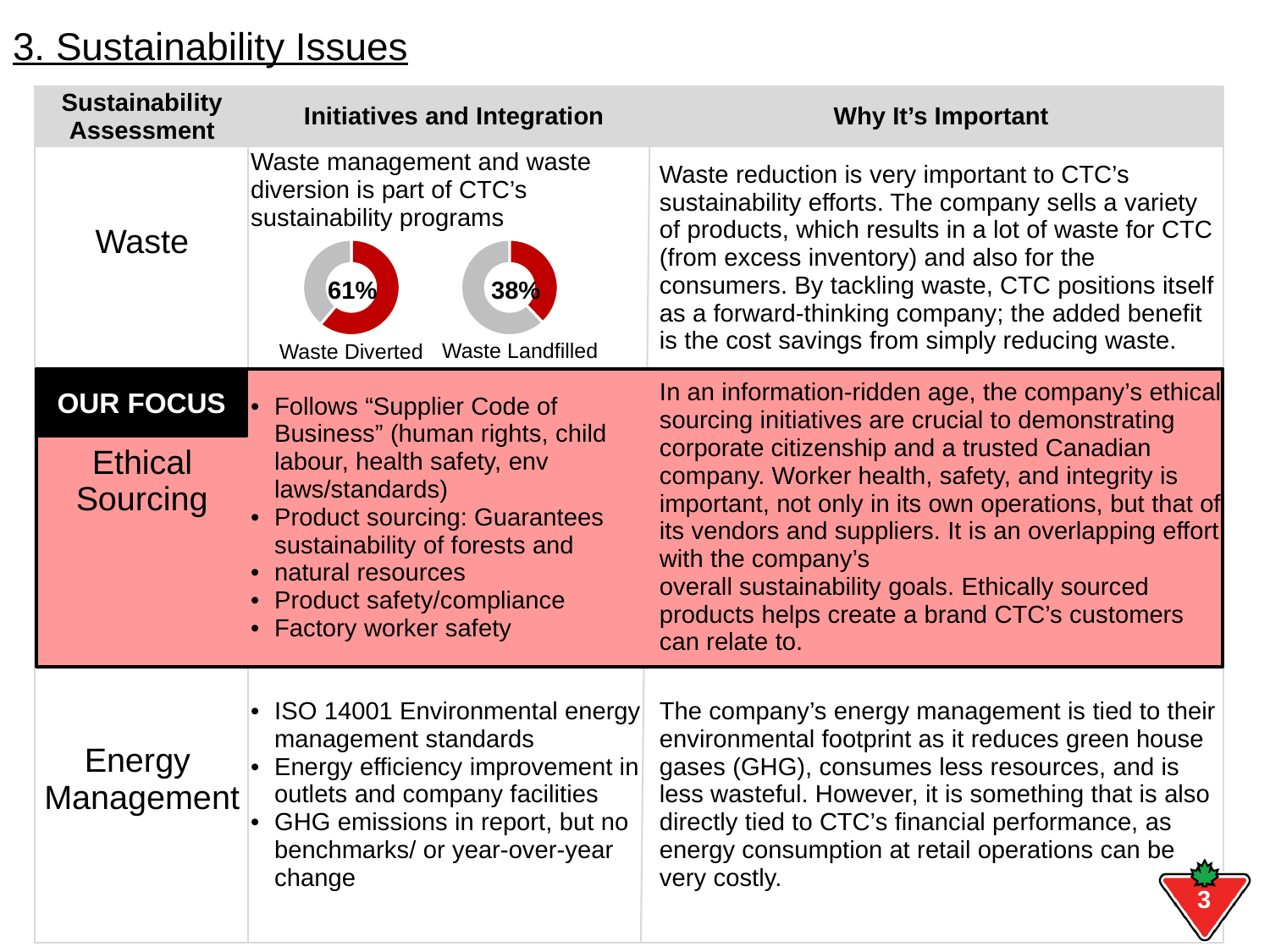
How many donut charts are shown in the Waste row of the table? 2 Is the Waste Diverted value greater or less than 50%? greater In which row of the Sustainability Assessment table do the donut charts appear? Waste Of the two donut charts, which one shows the lowest percentage? Waste Landfilled What is the difference in percentage points between the Waste Diverted value and the Waste Landfilled value? 23 percentage points Is the Waste Landfilled value greater or less than 50%? less What colour is used for the highlighted (value) portion of the donut charts? Red Which is larger, the Waste Diverted percentage or the Waste Landfilled percentage? Waste Diverted Of the two donut charts, which one shows the highest percentage? Waste Diverted What value is shown in the Waste Landfilled donut chart? 38% What value is shown in the Waste Diverted donut chart? 61% What kind of chart is used to show the Waste Diverted and Waste Landfilled values? Donut (pie) chart